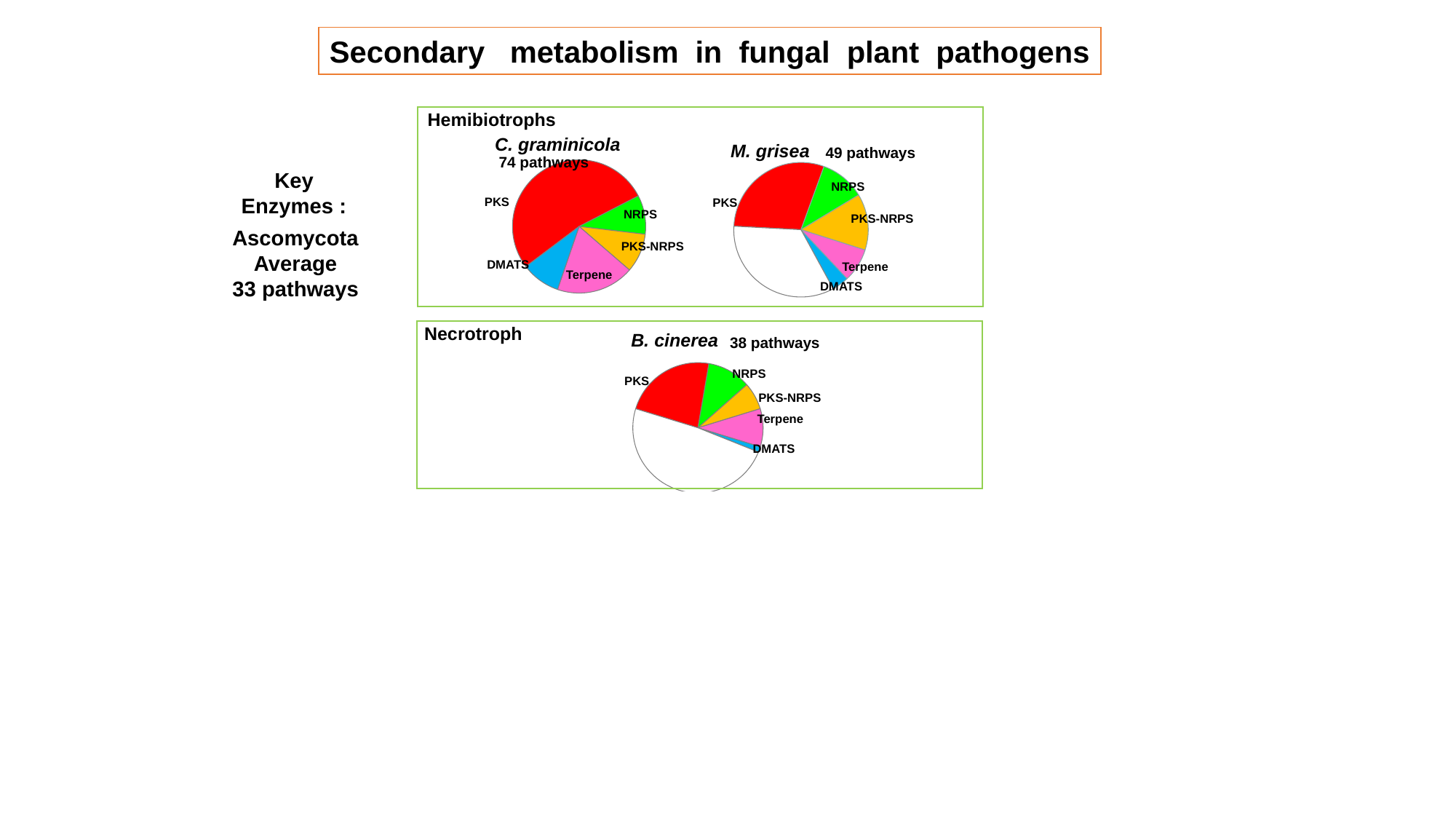
In the B. cinerea pie chart, which slice is larger, PKS or NRPS? PKS How many pathways are stated for M. grisea? 49 pathways In the C. graminicola pie chart, which enzyme class has the largest slice? PKS In the B. cinerea pie chart, which labelled enzyme class has the smallest slice? DMATS In the B. cinerea pie chart, which labelled enzyme class has the largest slice? PKS What kind of chart is used for C. graminicola? Pie chart How many labelled slices does the C. graminicola pie chart have? 5 In the M. grisea pie chart, which labelled enzyme class has the smallest slice? DMATS Which colour represents Terpene in the pie charts? Pink In the M. grisea pie chart, which labelled enzyme class has the largest slice? PKS In the M. grisea pie chart, which slice is larger, PKS-NRPS or DMATS? PKS-NRPS